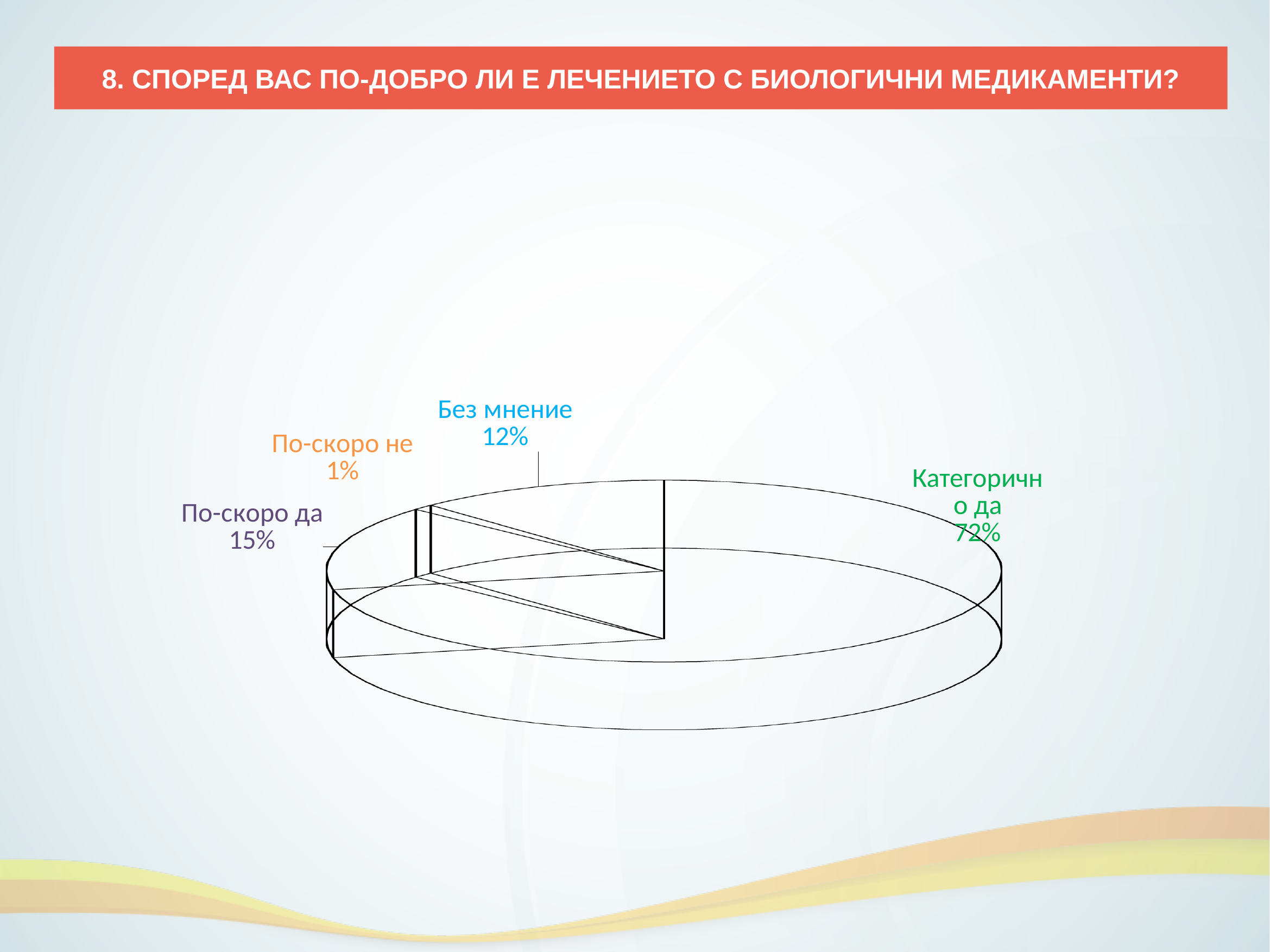
What share of the pie is labelled "По-скоро не"? 1% What share of the pie is labelled "По-скоро да"? 15% What share of the pie is labelled "Категорично да"? 72% What is the difference between the shares for "По-скоро да" and "Без мнение"? 3% Which category has the smallest share of the pie? По-скоро не What kind of chart is shown on the slide? pie chart Which is larger, the share for "По-скоро да" or the share for "Без мнение"? По-скоро да What is the title of the slide above the chart? 8. СПОРЕД ВАС ПО-ДОБРО ЛИ Е ЛЕЧЕНИЕТО С БИОЛОГИЧНИ МЕДИКАМЕНТИ? What share of the pie is labelled "Без мнение"? 12% How many categories does the pie chart show? 4 Which category has the largest share of the pie? Категорично да What is the difference between the shares for "Категорично да" and "По-скоро да"? 57%